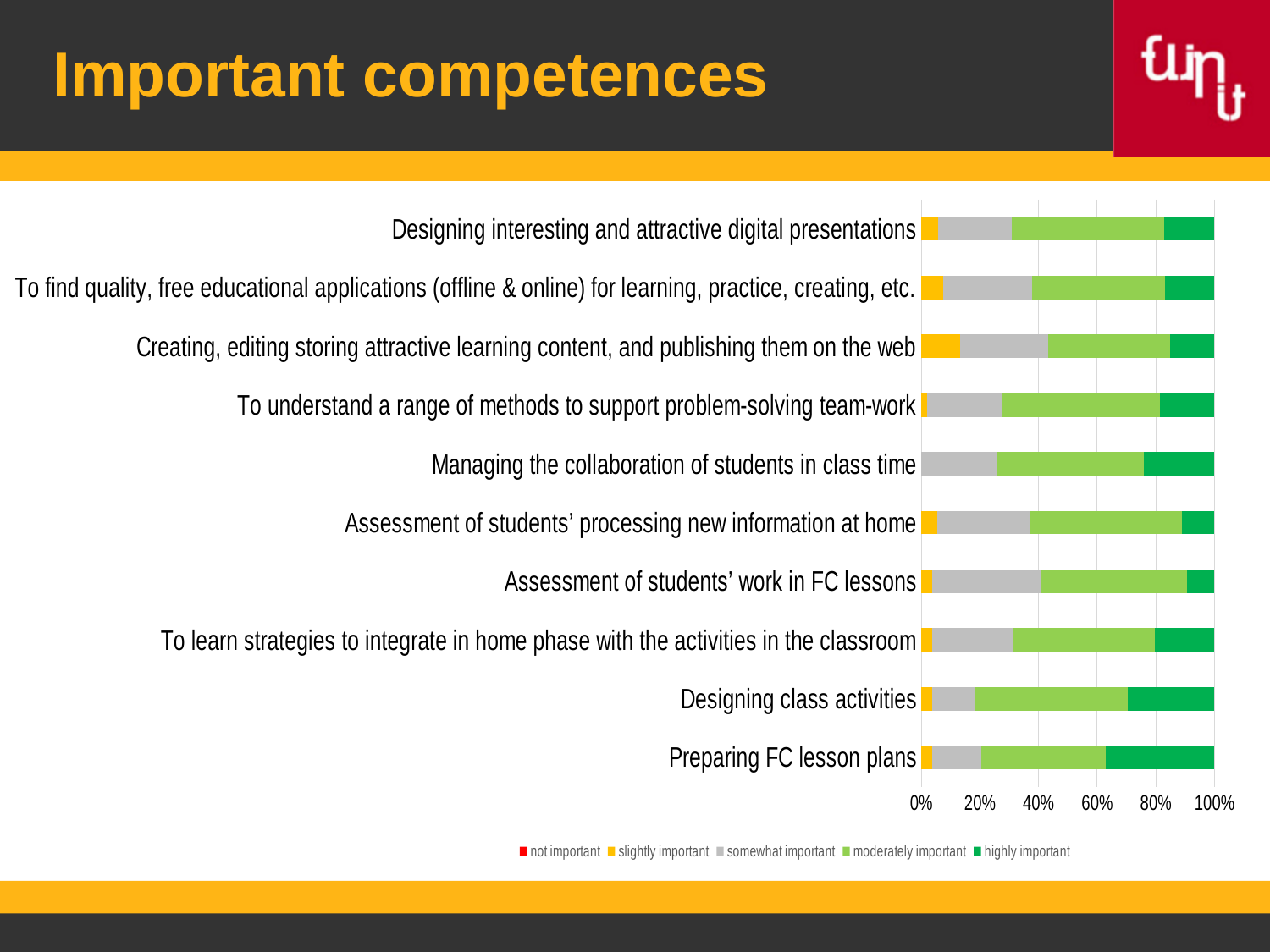
How many competences (categories) are plotted in the chart? 10 Which competence has the largest 'somewhat important' segment? Assessment of students' work in FC lessons Which competence has the largest 'slightly important' segment? Creating, editing storing attractive learning content, and publishing them on the web What kind of chart is shown on the slide? Stacked bar chart Which has a larger 'moderately important' segment: Assessment of students' work in FC lessons or Preparing FC lesson plans? Assessment of students' work in FC lessons Which has a larger 'highly important' segment: Preparing FC lesson plans or Assessment of students' work in FC lessons? Preparing FC lesson plans Which legend entry is shown in grey? somewhat important How many series does the legend list? 5 What is the highest value shown on the horizontal axis? 100% Is the 'highly important' share for Assessment of students' work in FC lessons greater or less than 20%? less Which competence has the largest 'highly important' segment? Preparing FC lesson plans Is the 'highly important' share for Preparing FC lesson plans greater or less than 20%? greater